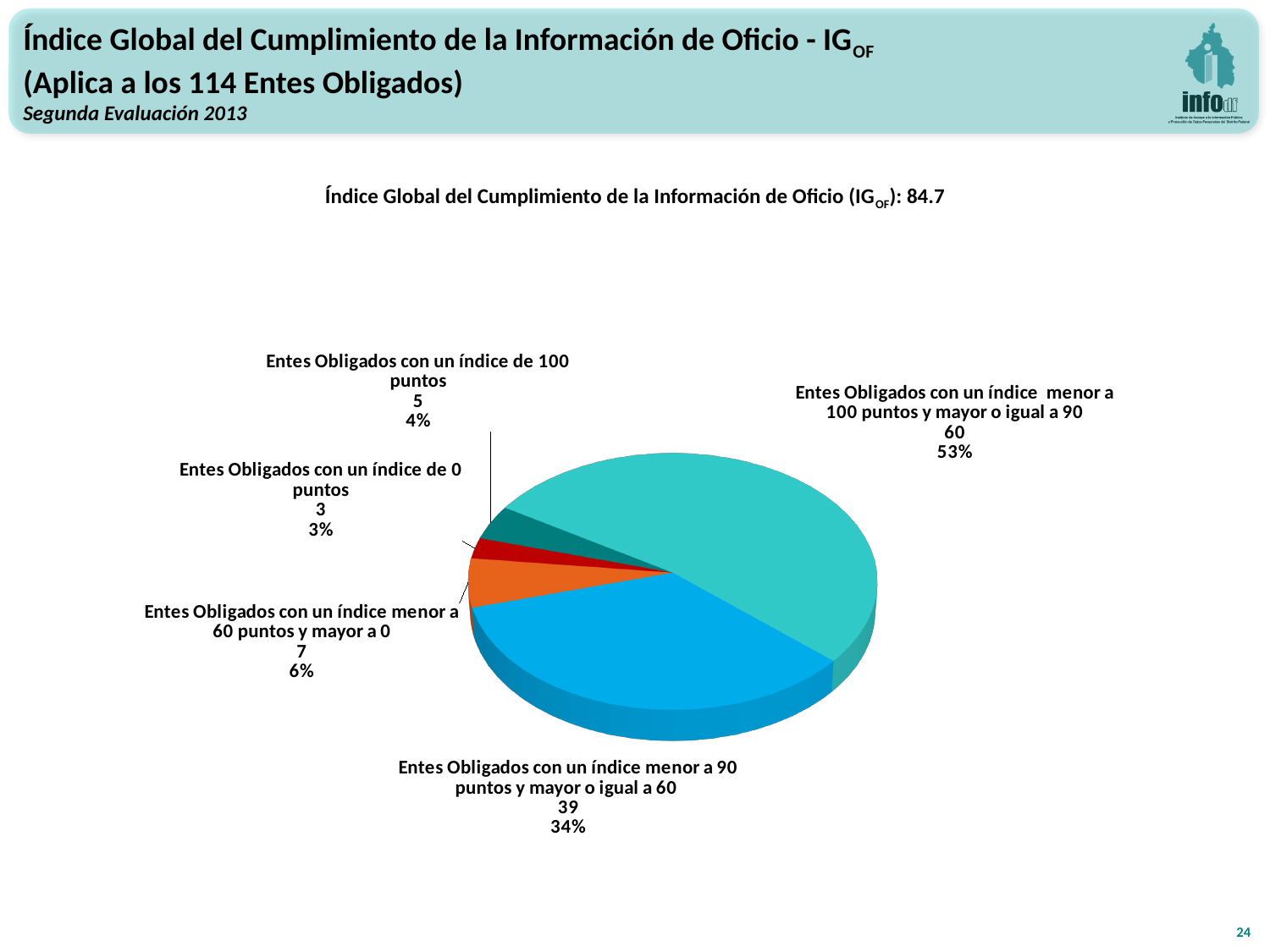
Which category has the smallest slice of the pie? Entes Obligados con un índice de 0 puntos What is the difference in count between 'Entes Obligados con un índice menor a 100 puntos y mayor o igual a 90' and 'Entes Obligados con un índice menor a 90 puntos y mayor o igual a 60'? 21 What colour is the slice for 'Entes Obligados con un índice menor a 90 puntos y mayor o igual a 60'? blue Which is larger: the number of Entes Obligados with an index less than 60 and greater than 0, or the number with an index of 100 points? Entes Obligados con un índice menor a 60 puntos y mayor a 0 How many slices does the pie chart have? 5 How many Entes Obligados have an index less than 90 points and greater than or equal to 60? 39 How many Entes Obligados have an index of 100 points? 5 What percentage of the pie corresponds to 'Entes Obligados con un índice de 0 puntos'? 3% What is the value of the Índice Global del Cumplimiento de la Información de Oficio (IGOF) stated above the chart? 84.7 What share of the pie is 'Entes Obligados con un índice menor a 100 puntos y mayor o igual a 90'? 53% Which category has the largest slice of the pie? Entes Obligados con un índice menor a 100 puntos y mayor o igual a 90 What kind of chart is shown on the slide? pie chart